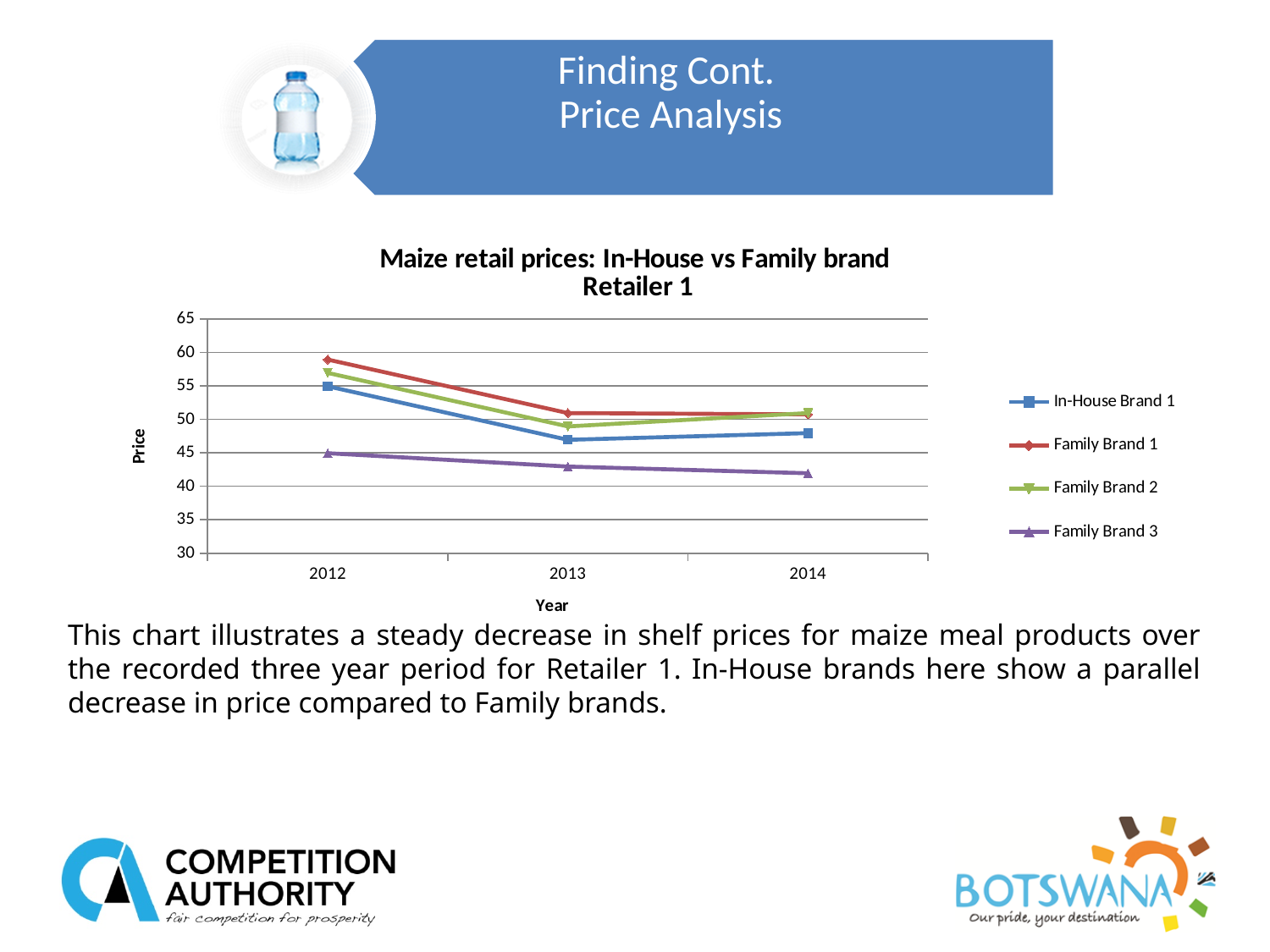
Is the price for Family Brand 3 in 2014 greater or less than 45? less Is the price for In-House Brand 1 in 2013 greater or less than 50? less How many years are shown on the x axis? 3 How many series does the legend list? 4 Which series has the lowest price in 2014? Family Brand 3 What kind of chart is shown on the slide? line chart Which series has the highest price in 2012? Family Brand 1 Which is higher in 2013, Family Brand 1 or In-House Brand 1? Family Brand 1 Is the price for Family Brand 1 in 2012 greater or less than 55? greater Does the price for Family Brand 3 rise or fall from 2012 to 2014? fall What is the title of the chart? Maize retail prices: In-House vs Family brand Retailer 1 Which series has the lowest price in 2012? Family Brand 3